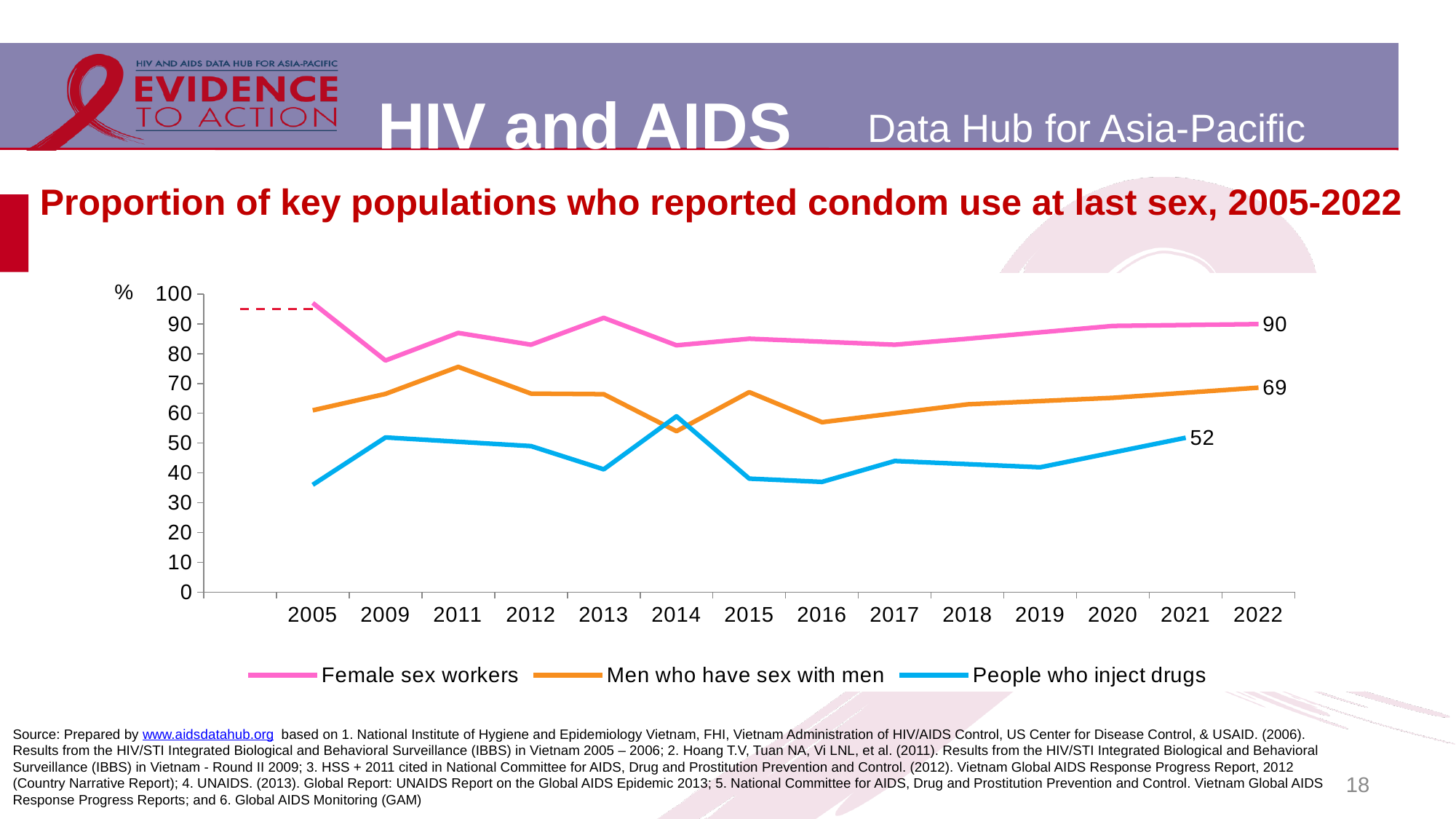
Is the value for People who inject drugs in 2005 greater or less than 40? less What is the difference between the 2022 values for Female sex workers and Men who have sex with men? 21 What is the value for Men who have sex with men in 2022? 69 What is the difference between the 2022 value for Men who have sex with men and the 2021 value for People who inject drugs? 17 What unit is shown on the y axis? % Which series has the highest value in 2022? Female sex workers How many series does the legend list? 3 What is the value for People who inject drugs in 2021? 52 How many years are shown on the x axis? 14 What kind of chart is shown on the slide? Line chart Is the value for Female sex workers in 2005 greater or less than 90? greater What is the value for Female sex workers in 2022? 90